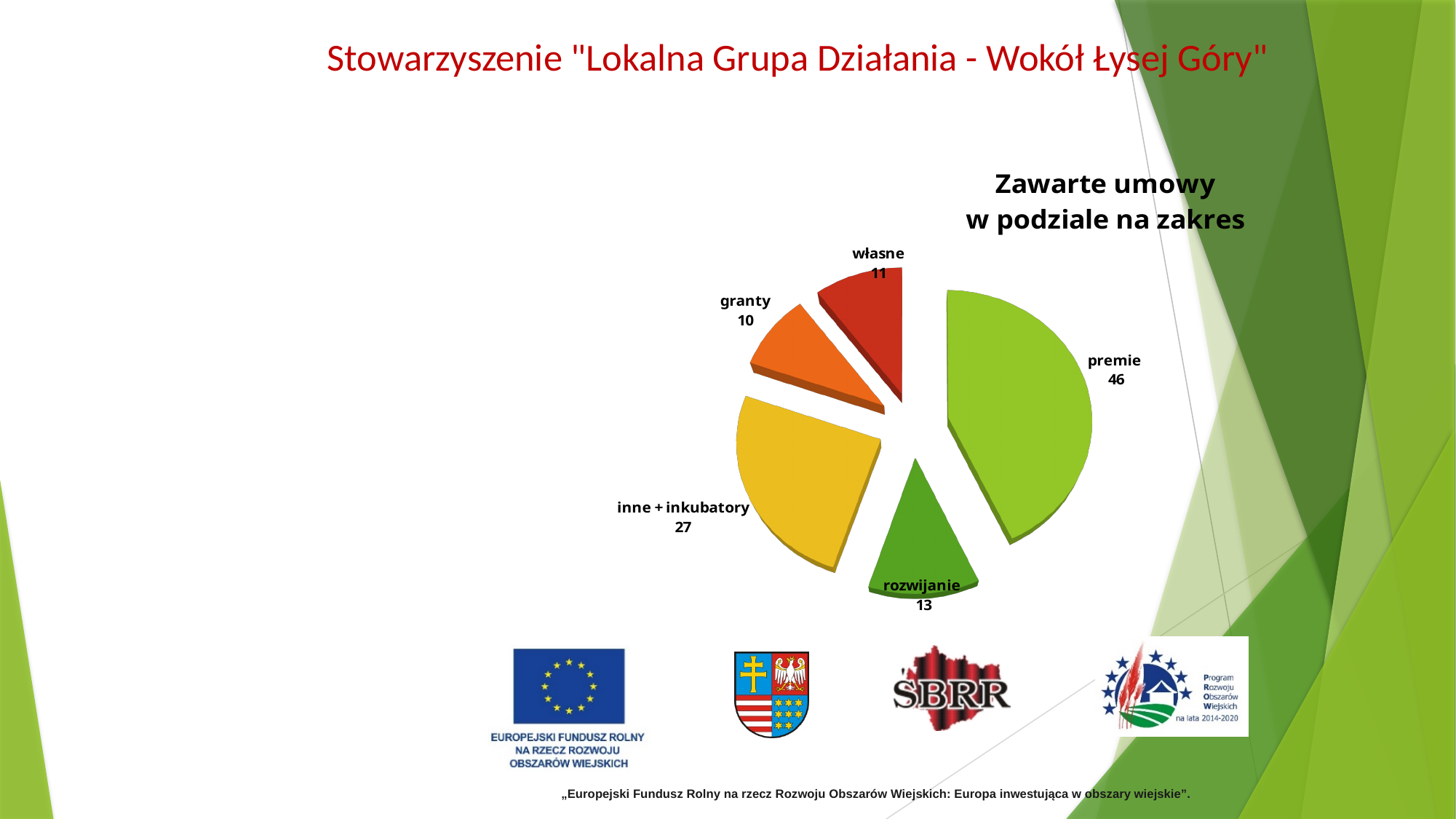
Which category has the smallest slice? granty What is the title of the chart? Zawarte umowy w podziale na zakres How many slices does the pie chart have? 5 What is the difference between the values for premie and inne + inkubatory? 19 What is the value for inne + inkubatory? 27 Which is larger, własne or granty? własne What is the value for granty? 10 What is the total of all slices in the pie chart? 107 What is the value for rozwijanie? 13 Which category has the largest slice? premie What is the value for premie? 46 What type of chart is shown on the slide? pie chart